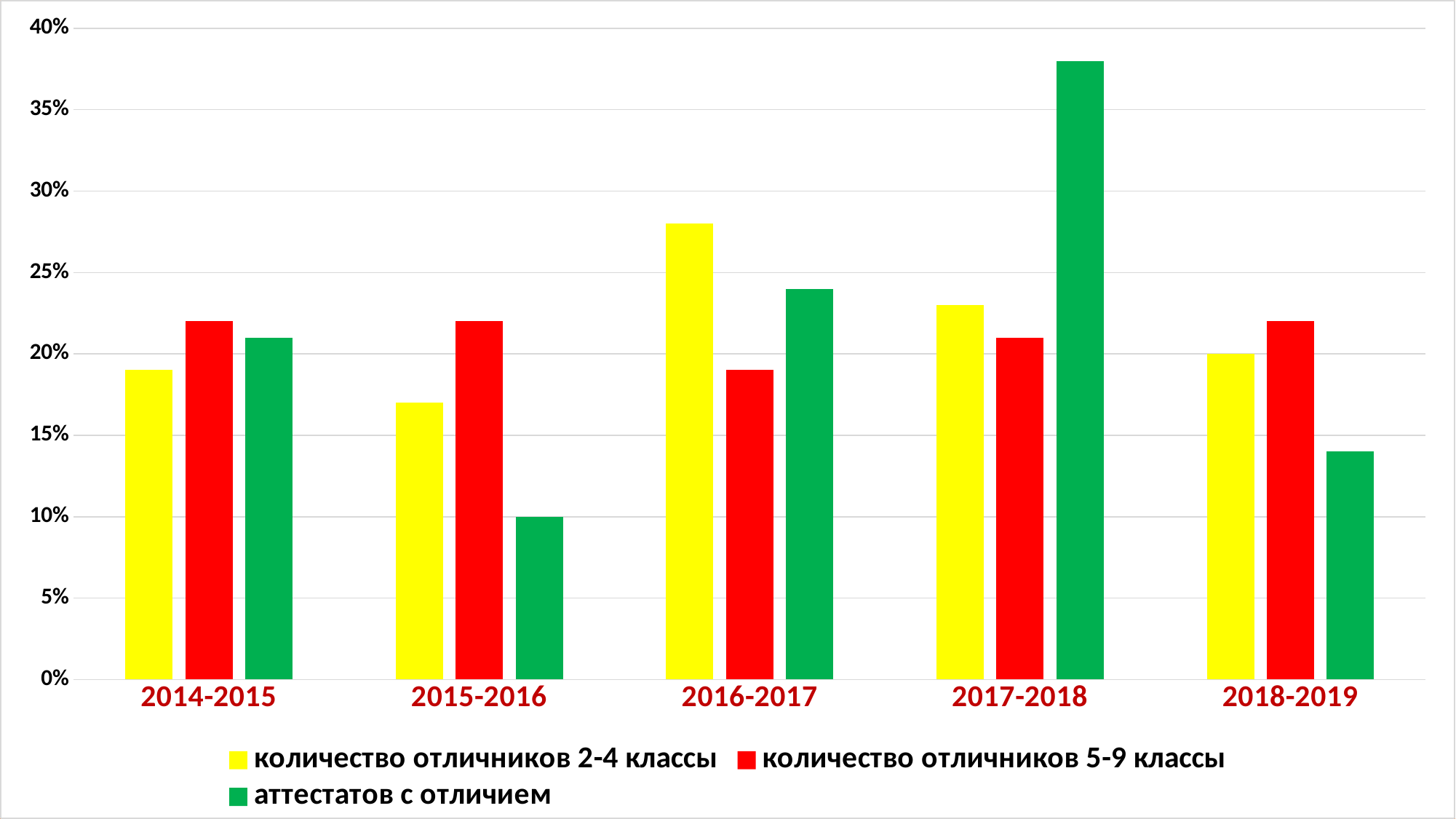
Is the value for 'количество отличников 2-4 классы' in 2016-2017 greater or less than 25%? greater What colour represents 'аттестатов с отличием' in the legend? green In which school year is the value for 'аттестатов с отличием' the lowest? 2015-2016 Is the value for 'аттестатов с отличием' in 2017-2018 greater or less than 35%? greater In which school year is the value for 'аттестатов с отличием' the highest? 2017-2018 How many school-year categories are shown on the x axis? 5 In which school year is the value for 'количество отличников 2-4 классы' the highest? 2016-2017 What kind of chart is shown on the slide? bar chart In 2016-2017, which is larger: 'количество отличников 2-4 классы' or 'количество отличников 5-9 классы'? количество отличников 2-4 классы How many series does the legend list? 3 In 2015-2016, which is larger: 'количество отличников 5-9 классы' or 'аттестатов с отличием'? количество отличников 5-9 классы